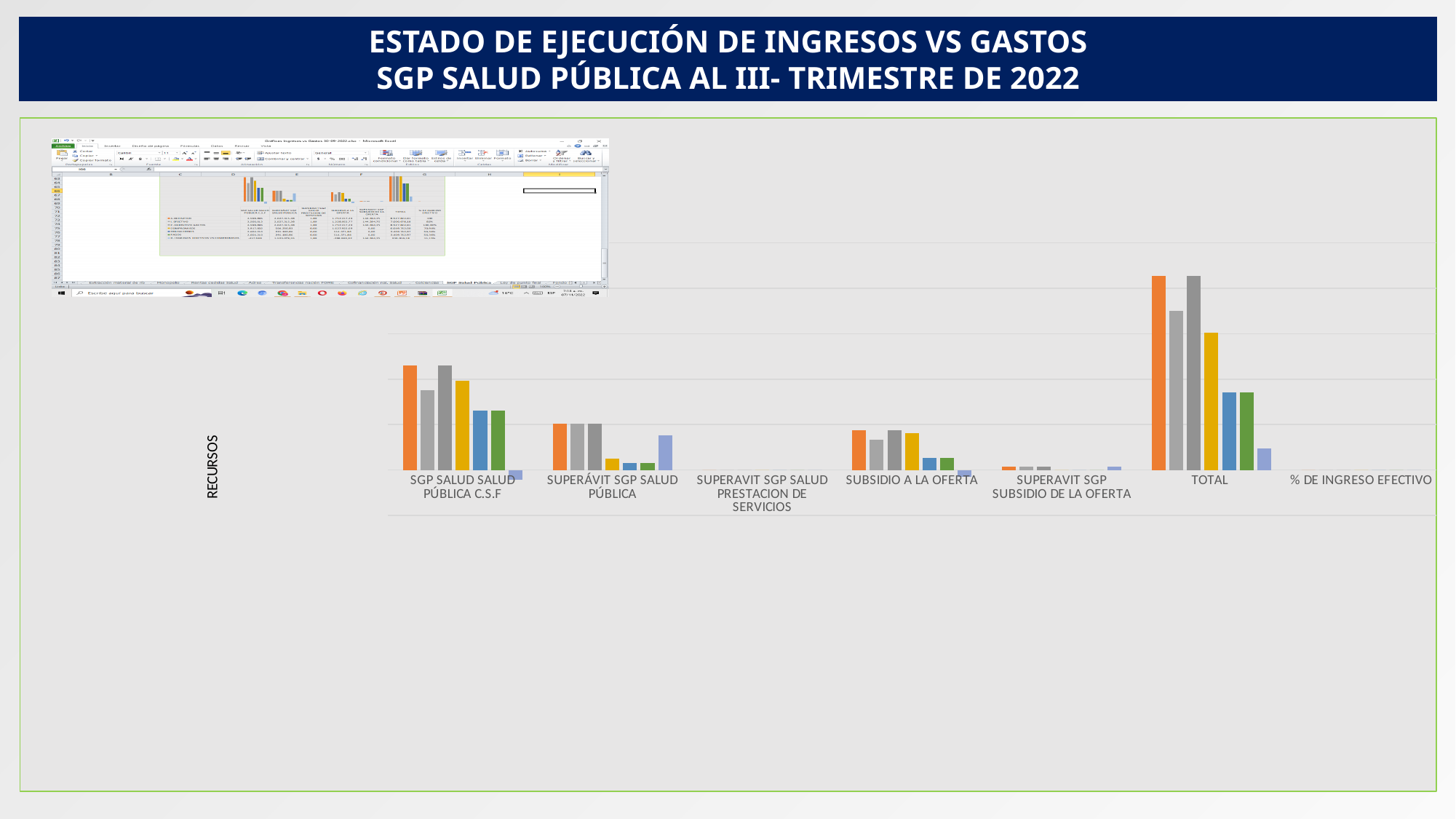
What is the label of the last category on the x axis of the chart? % DE INGRESO EFECTIVO Which category has taller bars, SGP SALUD SALUD PÚBLICA C.S.F or SUBSIDIO A LA OFERTA? SGP SALUD SALUD PÚBLICA C.S.F What kind of chart is shown on the slide? bar chart Which category has taller bars, SUPERÁVIT SGP SALUD PÚBLICA or SUPERAVIT SGP SUBSIDIO DE LA OFERTA? SUPERÁVIT SGP SALUD PÚBLICA How many categories are shown along the x axis of the chart? 7 Which category has taller bars, TOTAL or SUBSIDIO A LA OFERTA? TOTAL Which category has the tallest bars in the chart? TOTAL What is the label on the vertical axis of the chart? RECURSOS